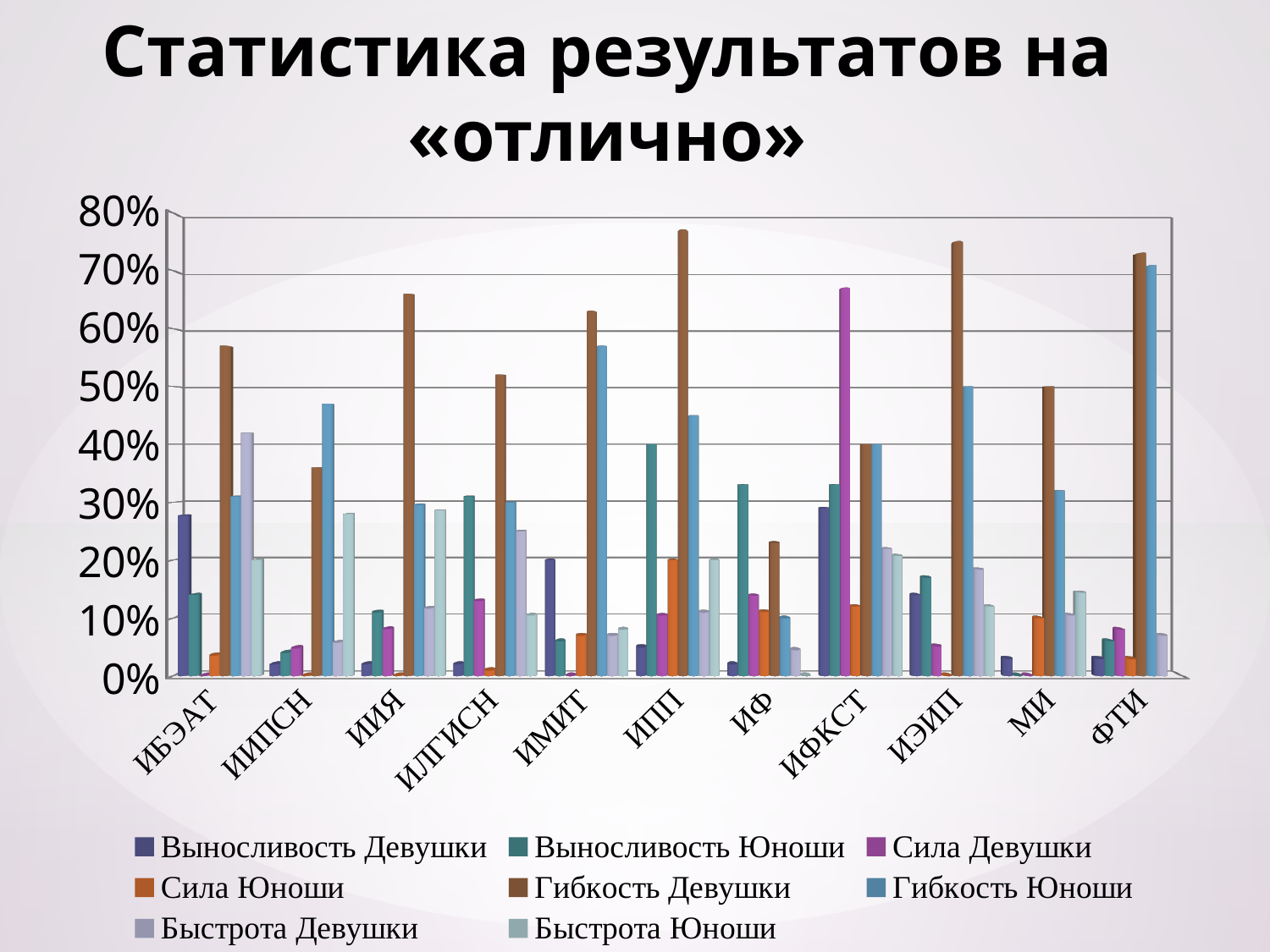
Which is larger: Гибкость Девушки for ИИЯ or Гибкость Девушки for ИЛГИСН? ИИЯ Is the value of Сила Девушки for ИФКСТ greater or less than 60%? greater How many series does the legend list? 8 Is the value of Гибкость Юноши for ФТИ greater or less than 60%? greater Is the value of Гибкость Юноши for ИИПСН greater or less than 40%? greater Which series has the highest value for ИФКСТ? Сила Девушки How many categories (institutes) are shown along the x axis? 11 What is the title of the chart on the slide? Статистика результатов на «отлично» Which series has the highest value for ИИПСН? Гибкость Юноши For ИФ, which is larger: Выносливость Юноши or Гибкость Девушки? Выносливость Юноши What kind of chart is shown on the slide? Bar chart